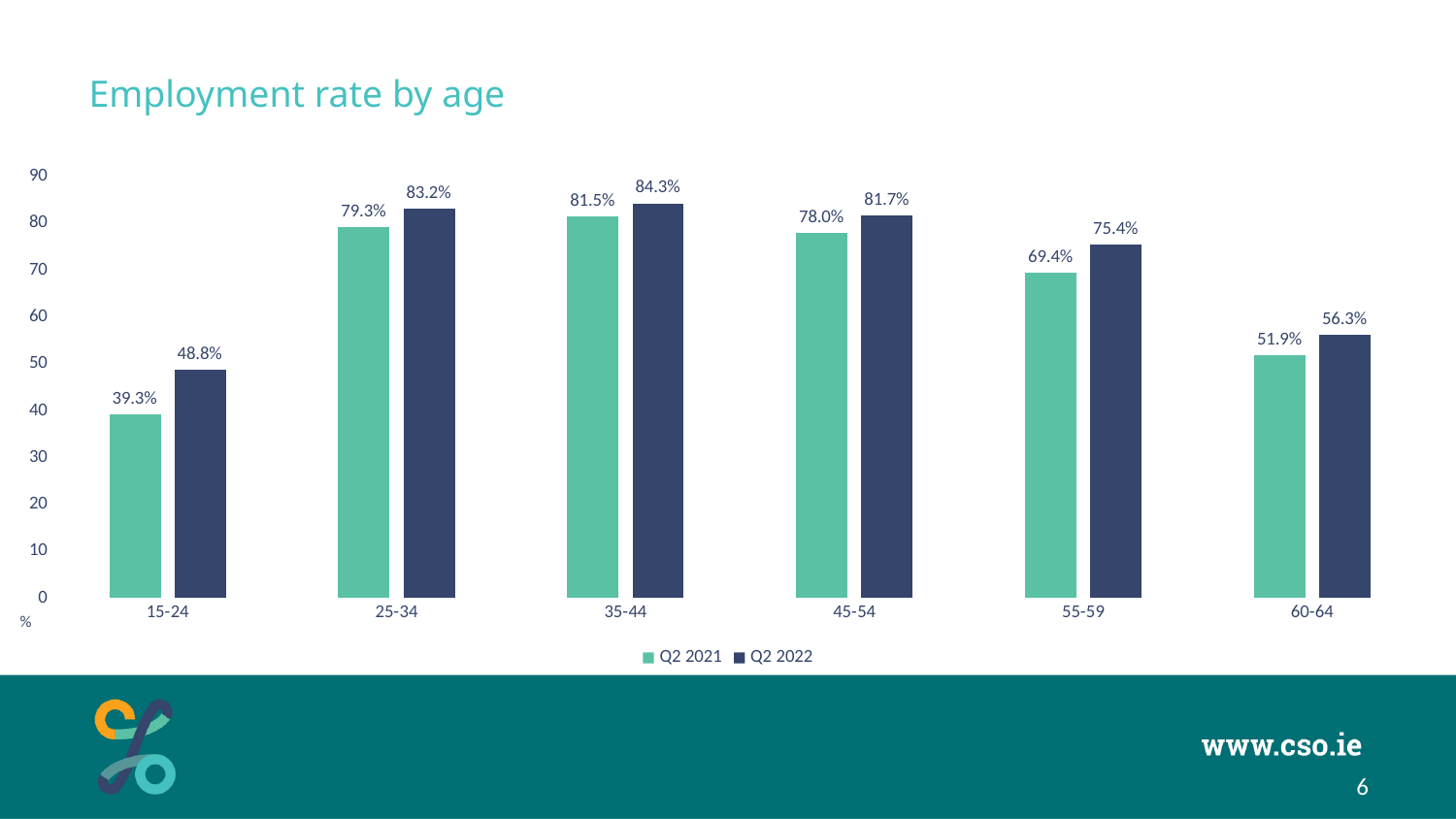
What is the employment rate for the 15-24 age group in Q2 2022? 48.8% How many age groups are shown on the chart? 6 Which age group has the lowest employment rate in Q2 2021? 15-24 What is the employment rate for the 55-59 age group in Q2 2021? 69.4% What is the title of the chart? Employment rate by age What kind of chart is shown on the slide? Bar chart How many series does the legend list? 2 Is the Q2 2021 employment rate for the 60-64 age group greater or less than 60? less Did the employment rate rise or fall between Q2 2021 and Q2 2022 for every age group? Rise Which age group has the highest employment rate in Q2 2022? 35-44 What is the difference between the Q2 2022 and Q2 2021 employment rates for the 15-24 age group? 9.5 percentage points Which is larger: the Q2 2021 employment rate for 25-34 or for 45-54? 25-34